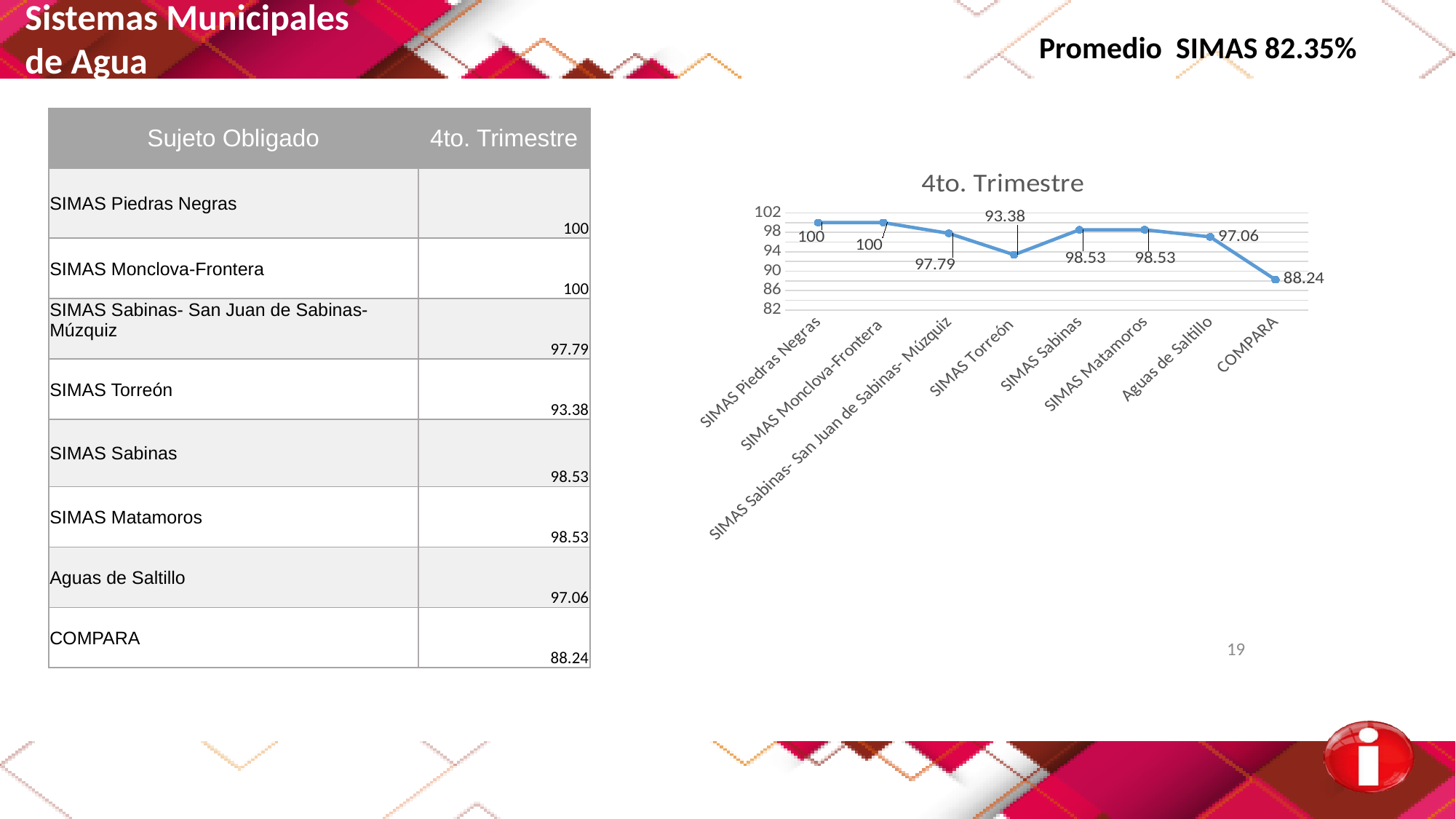
What is the title of the chart? 4to. Trimestre What is the value for SIMAS Torreón in the chart? 93.38 What is the value for SIMAS Sabinas- San Juan de Sabinas- Múzquiz in the chart? 97.79 Which is larger, the value for Aguas de Saltillo or the value for SIMAS Torreón? Aguas de Saltillo What kind of chart is shown on the slide? line chart What is the difference between the values for SIMAS Sabinas and SIMAS Torreón? 5.15 How many categories are plotted in the chart? 8 What is the value for Aguas de Saltillo in the chart? 97.06 What is the difference between the values for SIMAS Piedras Negras and COMPARA? 11.76 Which category has the lowest value in the chart? COMPARA Is the value for COMPARA greater or less than 90? less What is the value for COMPARA in the chart? 88.24